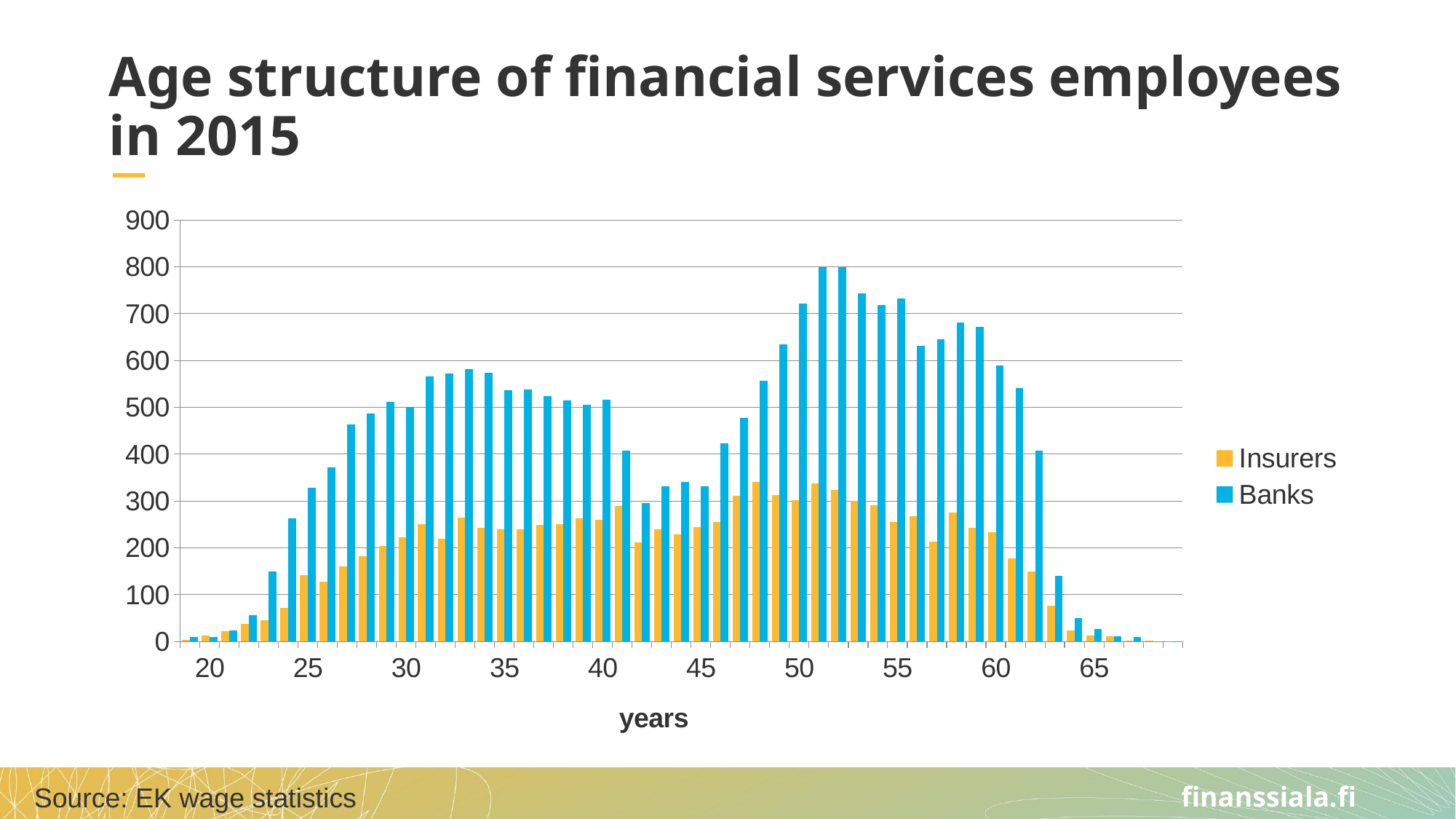
Do the values for Insurers rise or fall from age 60 to age 65? fall Is the value for Insurers at age 25 greater or less than 200? less How many series does the legend list? 2 Which two series are listed in the legend? Insurers and Banks Is the value for Banks at age 45 greater or less than 400? less Is the value for Banks at age 50 greater or less than 700? greater What kind of chart is shown on the slide? bar chart What is the label on the x axis? years At age 50, which series has the larger value, Insurers or Banks? Banks Do the values for Banks rise or fall from age 45 to age 51? rise